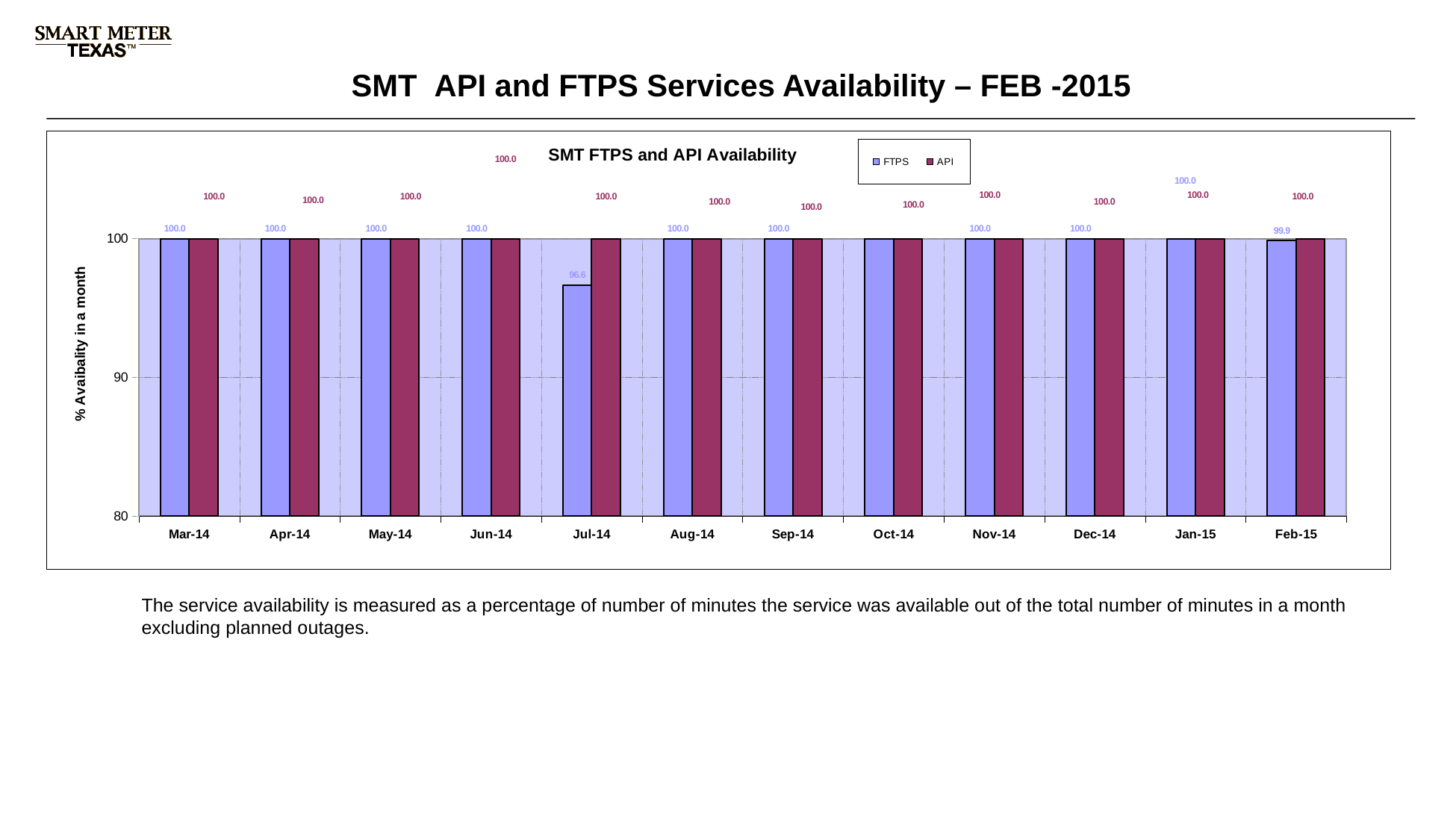
What is the API availability value for Jul-14? 100.0 What is the title of the chart? SMT FTPS and API Availability Which is larger for Jul-14, the FTPS value or the API value? API What is the FTPS availability value for Jul-14? 96.6 Is the FTPS value for Jul-14 greater or less than 90? greater How many months are shown on the x axis of the chart? 12 What is the label of the y axis of the chart? % Avaibality in a month Which month has the lowest FTPS availability? Jul-14 What is the FTPS availability value for Feb-15? 99.9 What type of chart is shown on the slide? bar chart How many series does the chart legend list? 2 What is the difference between the API and FTPS availability values for Jul-14? 3.4